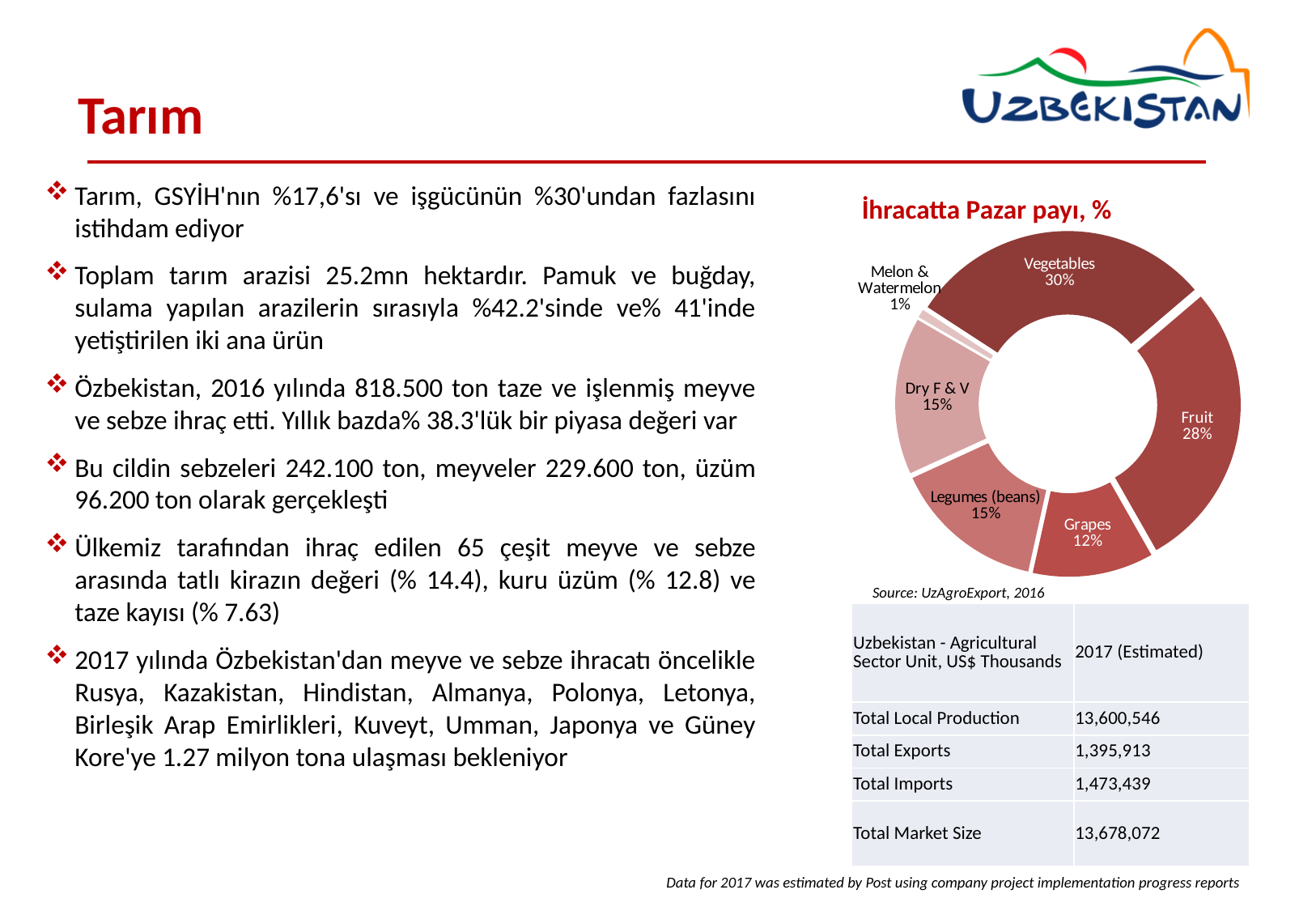
What share of the chart does Grapes have? 12% Which has a larger share, Fruit or Dry F & V? Fruit Which category has the largest share in the chart? Vegetables What is the difference between the shares of Vegetables and Grapes? 18% Which category has the smallest share in the chart? Melon & Watermelon What share of the chart does Vegetables have? 30% What kind of chart is shown on the slide? Pie chart (donut) How many categories are shown in the chart? 6 What share of the chart does Legumes (beans) have? 15% What share of the chart does Melon & Watermelon have? 1% What share of the chart does Fruit have? 28% What is the title of the chart? İhracatta Pazar payı, %